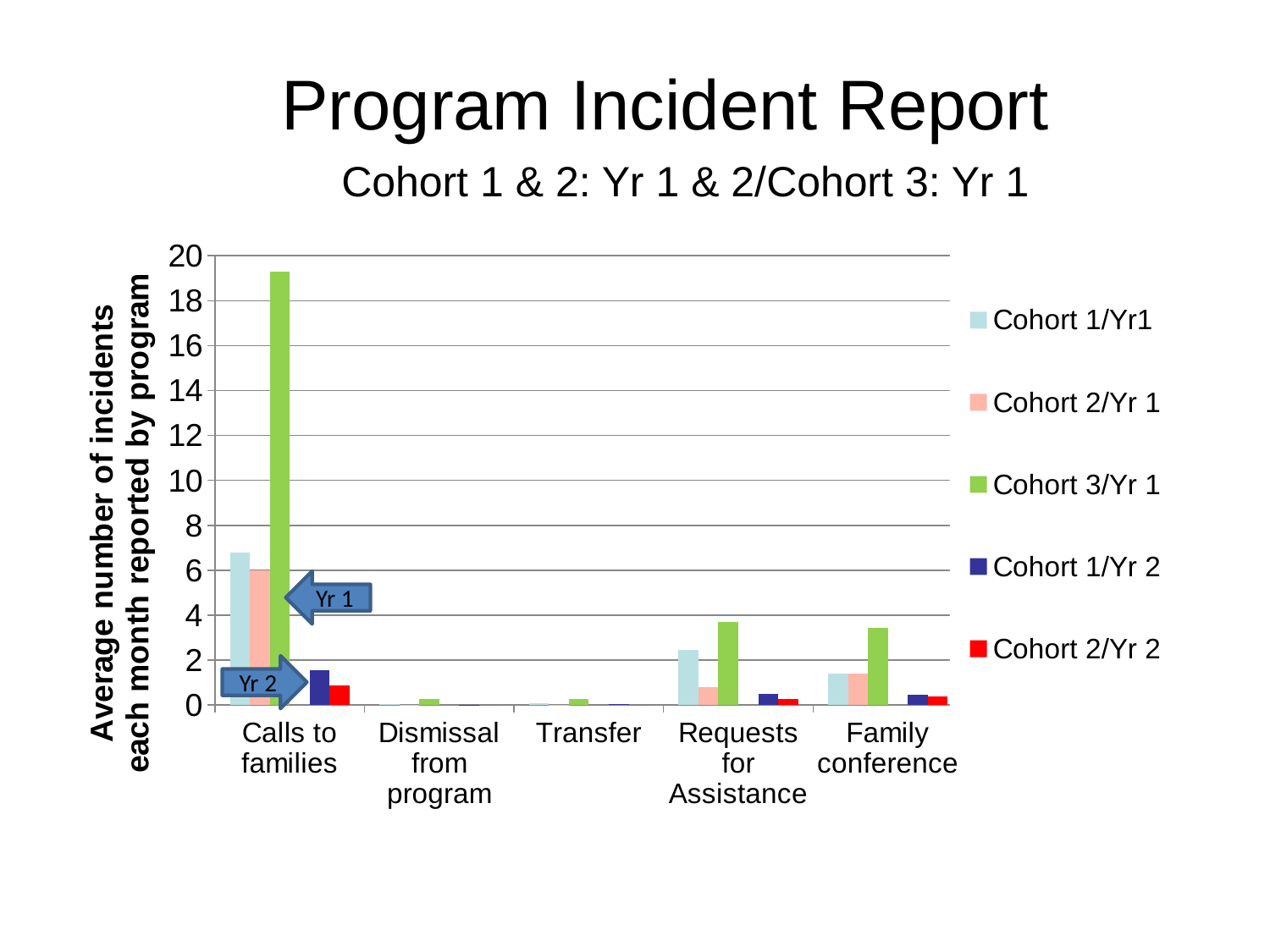
What is the title of the y axis? Average number of incidents each month reported by program For the Cohort 3/Yr 1 series, which category has the highest value? Calls to families For Calls to families, which is larger: Cohort 1/Yr 2 or Cohort 2/Yr 2? Cohort 1/Yr 2 Is the Cohort 1/Yr1 value for Calls to families greater or less than 6? greater Which category has the tallest bar in the chart? Calls to families How many categories are shown on the x axis? 5 Is the Cohort 3/Yr 1 value for Requests for Assistance greater or less than 4? less Is the Cohort 3/Yr 1 value for Family conference greater or less than 2? greater For Calls to families, which is larger: Cohort 1/Yr1 or Cohort 3/Yr 1? Cohort 3/Yr 1 What kind of chart is shown on the slide? Bar chart How many series does the legend list? 5